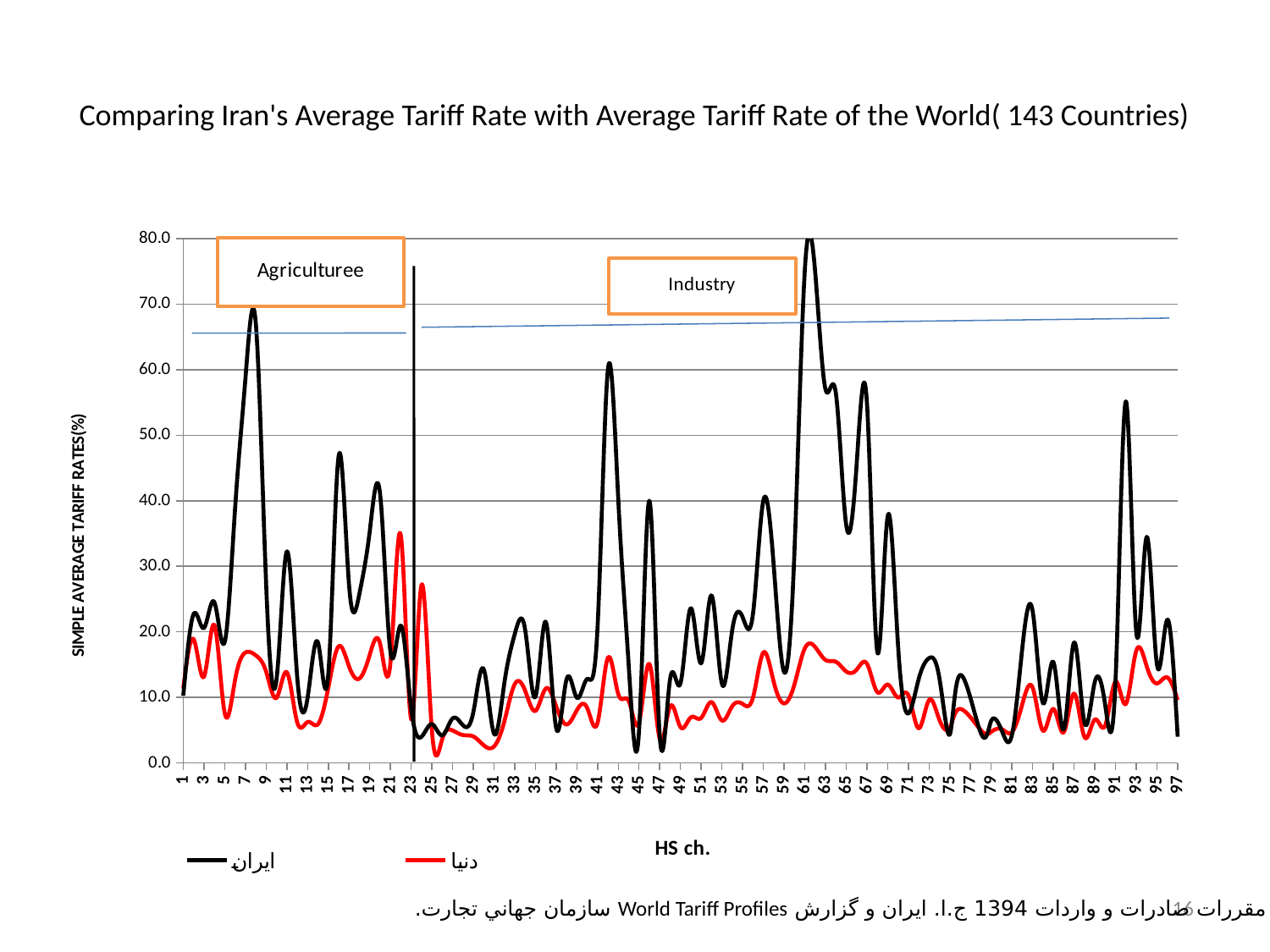
What kind of chart is shown on the slide? line chart At HS ch. 62, which series has the larger value, ایران (black) or دنیا (red)? ایران How many series does the legend list? 2 Is the peak value of the ایران (black) series greater or less than 70? greater Is the value of the دنیا (red) series at HS ch. 22 greater or less than 30? greater What is the label of the vertical axis? SIMPLE AVERAGE TARIFF RATES(%) What is the title of the chart? Comparing Iran's Average Tariff Rate with Average Tariff Rate of the World( 143 Countries) Is the value of the ایران (black) series at HS ch. 42 greater or less than 50? greater At HS ch. 7, which series has the larger value, ایران (black) or دنیا (red)? ایران Which series reaches the highest value on the chart, ایران (black) or دنیا (red)? ایران